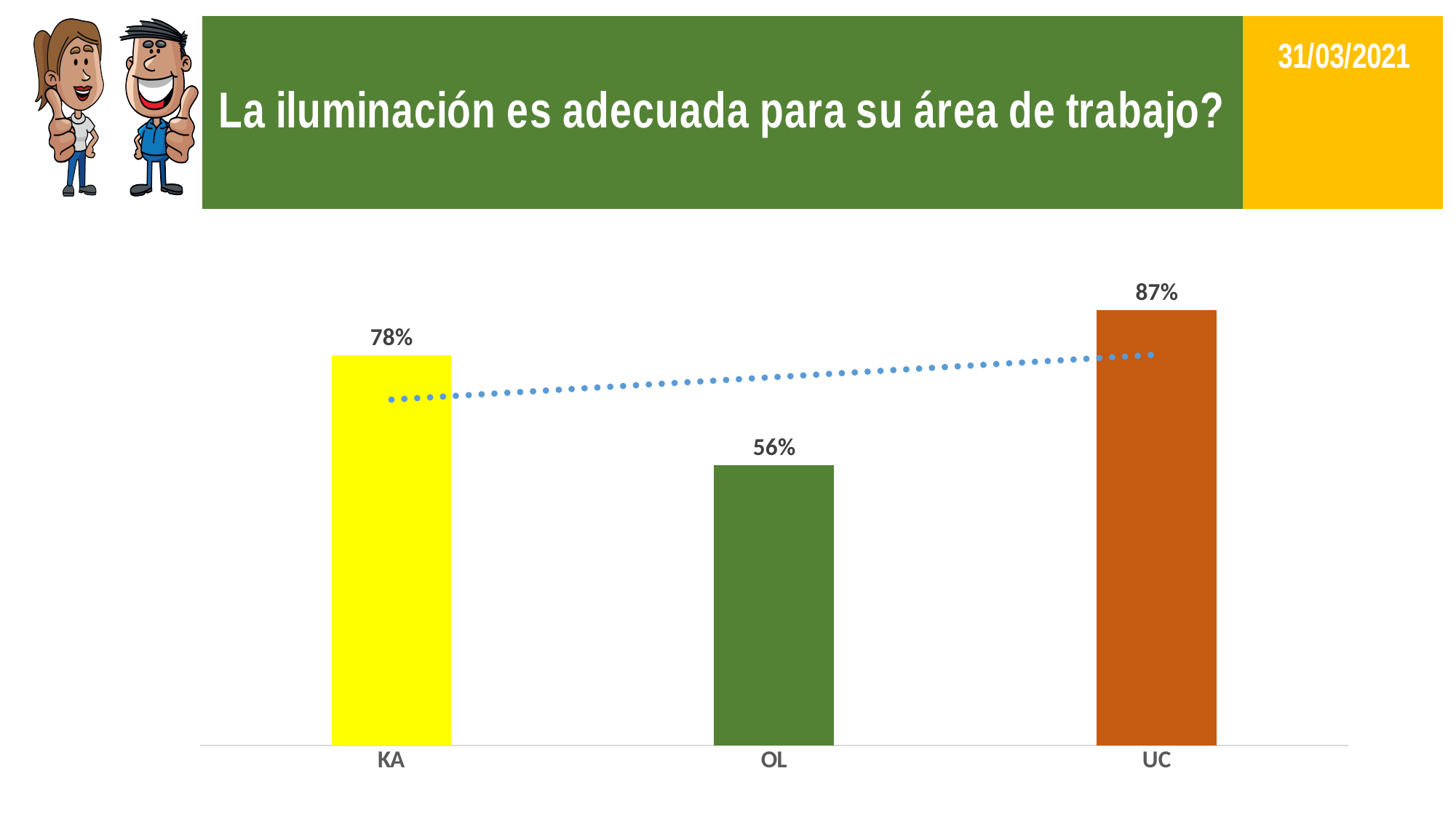
What is the value for KA? 78% How many categories are shown on the x axis? 3 What is the title of the slide above the chart? La iluminación es adecuada para su área de trabajo? What is the difference between the values for KA and OL? 22% What colour is the bar for UC? orange Which category has the lowest value? OL Which category has the highest value? UC What is the value for UC? 87% What is the value for OL? 56% Which is larger, the value for KA or the value for OL? KA What kind of chart is shown on the slide? bar chart What is the difference between the values for UC and KA? 9%